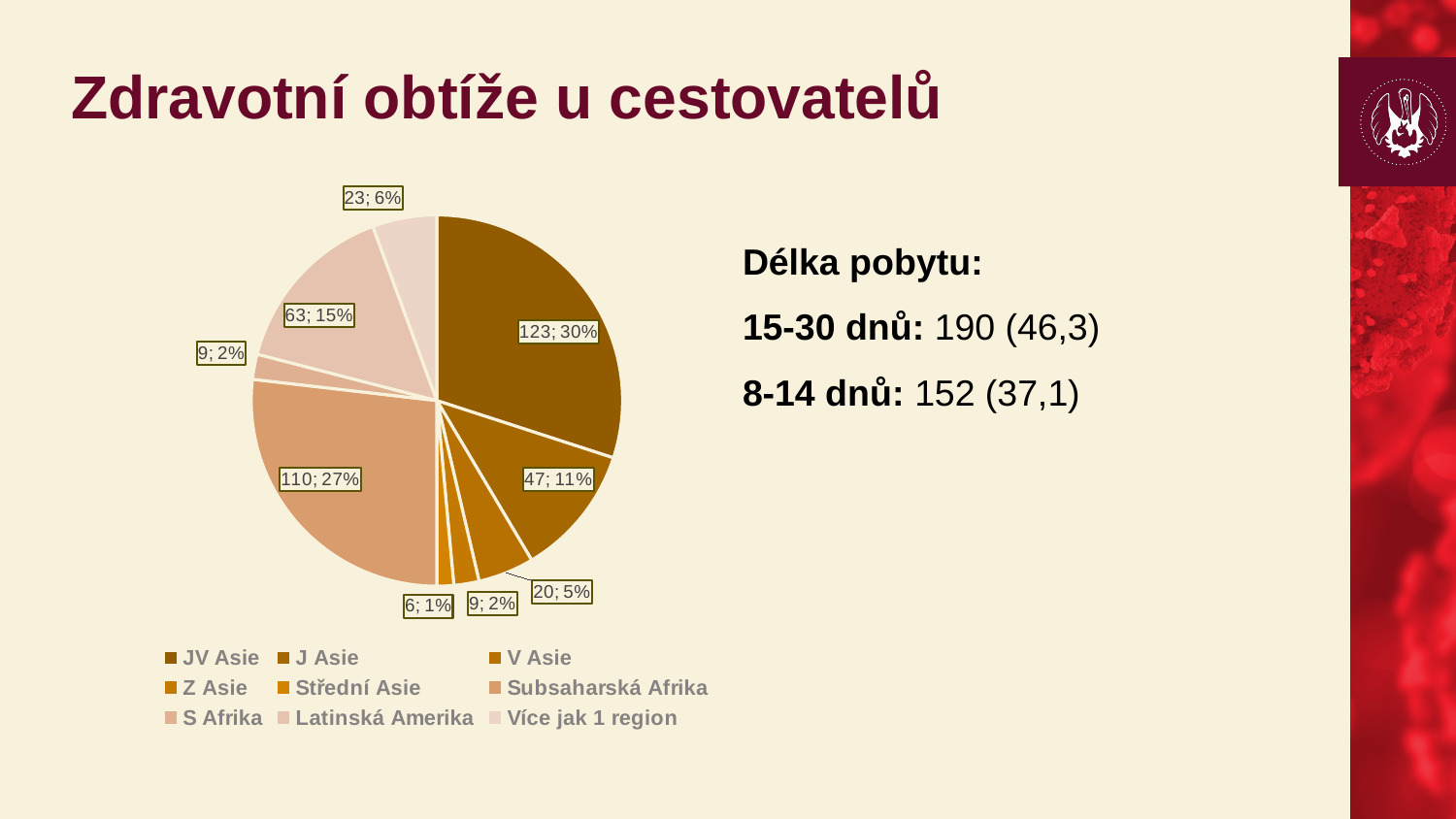
What is the data label shown for the JV Asie slice? 123; 30% What kind of chart is shown on the slide? pie chart What is the title of the slide containing the pie chart? Zdravotní obtíže u cestovatelů What is the data label shown for the Subsaharská Afrika slice? 110; 27% What share of the pie does J Asie represent? 11% Which category has the smallest slice of the pie chart? Střední Asie What is the difference between the count for JV Asie (123) and the count for Subsaharská Afrika (110)? 13 What is the data label shown for the Více jak 1 region slice? 23; 6% How many categories does the pie chart's legend list? 9 Which category has the largest slice of the pie chart? JV Asie What share of the pie does Latinská Amerika represent? 15% Which slice is larger, J Asie or V Asie? J Asie